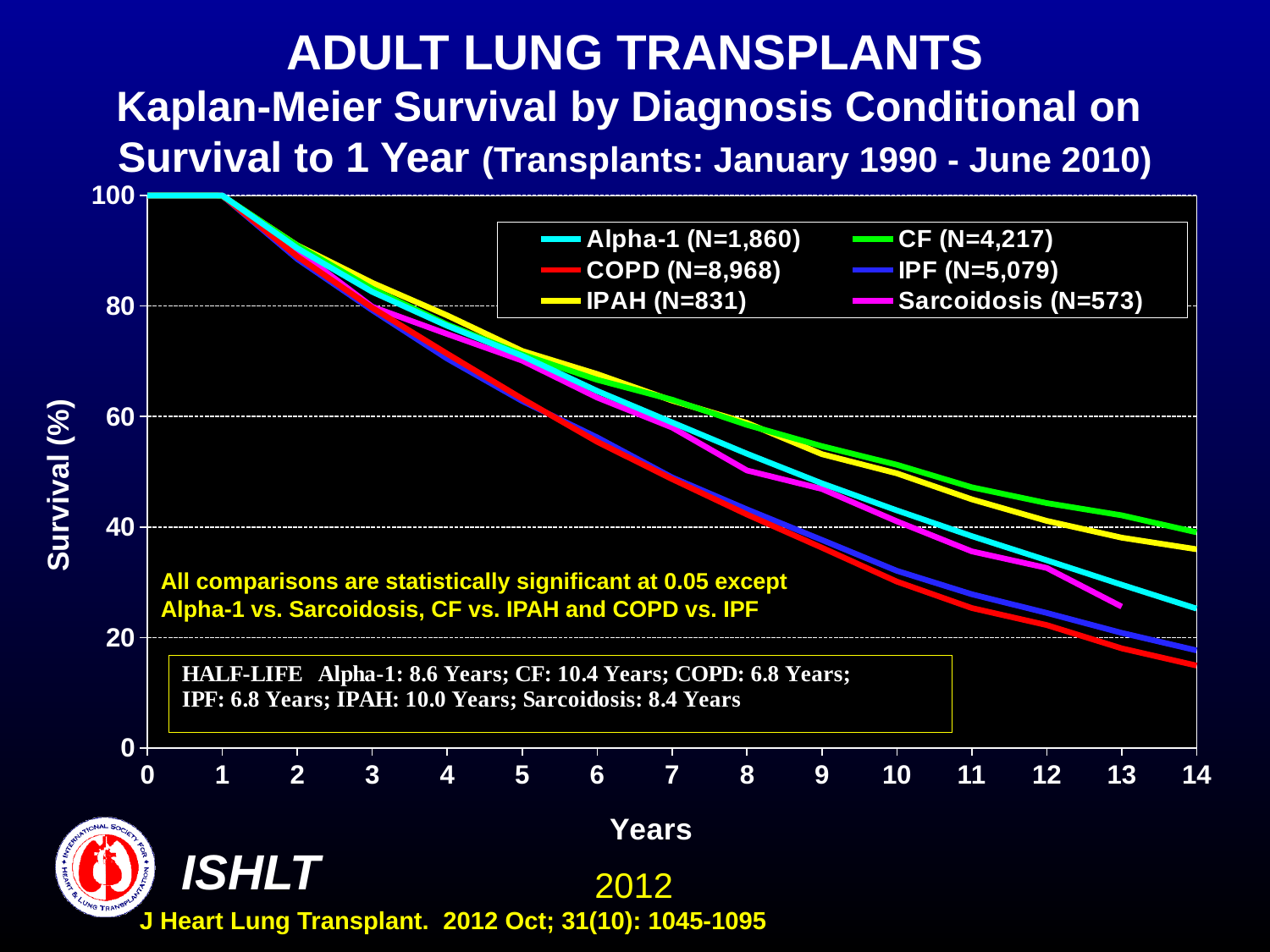
What is the number of patients (N) for the COPD series? 8,968 What is the half-life for CF according to the slide? 10.4 Years How many series does the legend list? 6 What is the number of patients (N) for the Sarcoidosis series? 573 What kind of chart is shown on the slide? line chart Is the survival value for COPD at 14 years greater or less than 20? less Is the survival value for IPAH at 5 years greater or less than 60? greater Is the survival value for CF at 14 years greater or less than 20? greater Which diagnosis has the longest half-life listed on the slide? CF At 10 years, which has higher survival, CF or COPD? CF Do the survival curves rise or fall as years increase along the x axis? fall What is the half-life for Alpha-1 according to the slide? 8.6 Years